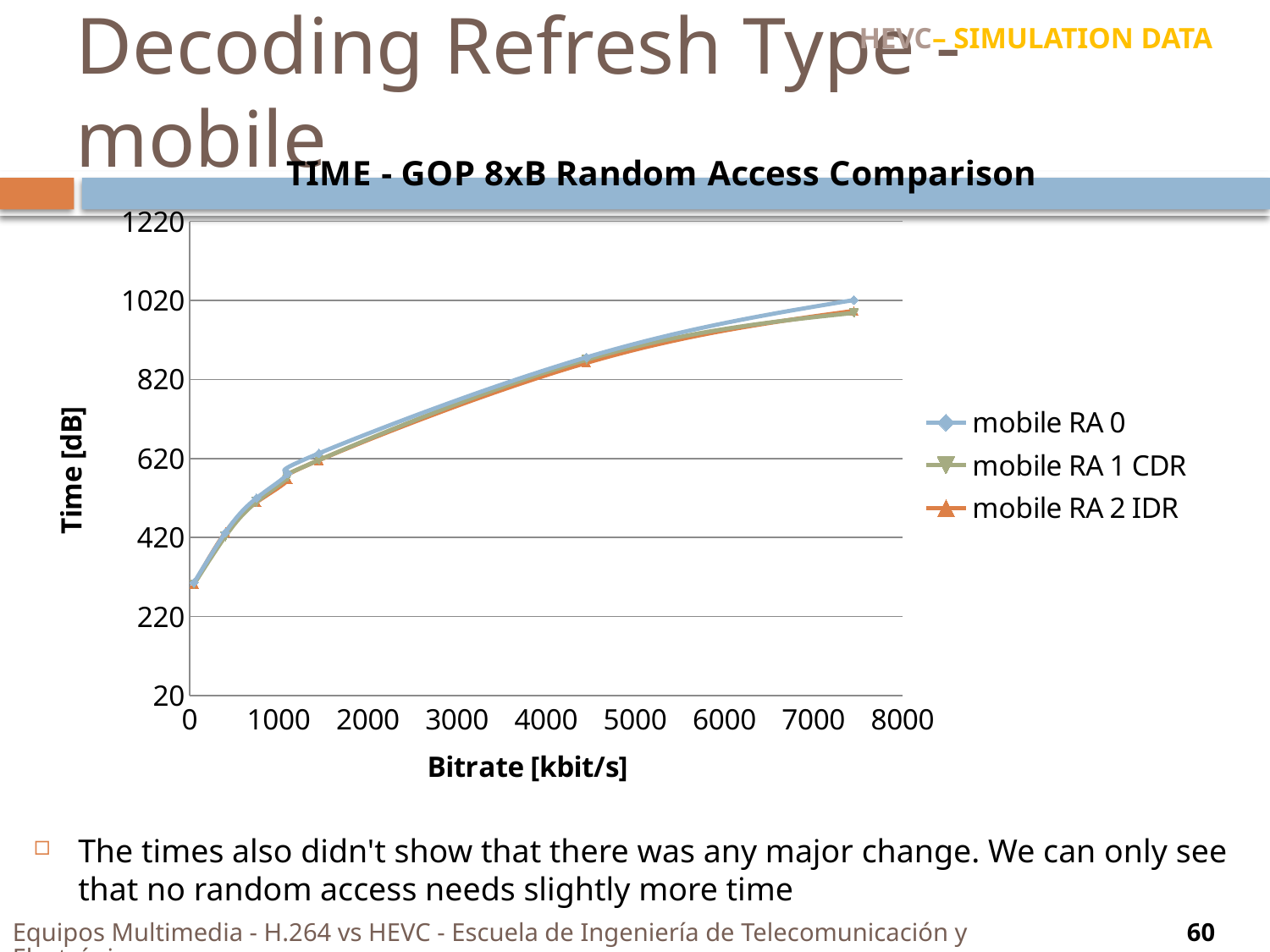
Is the value for mobile RA 2 IDR at the lowest bitrate greater or less than 420? less What is the title of the chart? TIME - GOP 8xB Random Access Comparison What is the label of the x axis? Bitrate [kbit/s] Is the value for mobile RA 1 CDR at the lowest bitrate greater or less than 220? greater At the highest bitrate, which series has the larger value: mobile RA 0 or mobile RA 2 IDR? mobile RA 0 Is the value for mobile RA 0 at the highest bitrate greater or less than 820? greater Do the values for mobile RA 2 IDR rise or fall along the x axis? rise Do the values for mobile RA 0 rise or fall as bitrate increases? rise What kind of chart is shown on the slide? line chart How many series does the legend list? 3